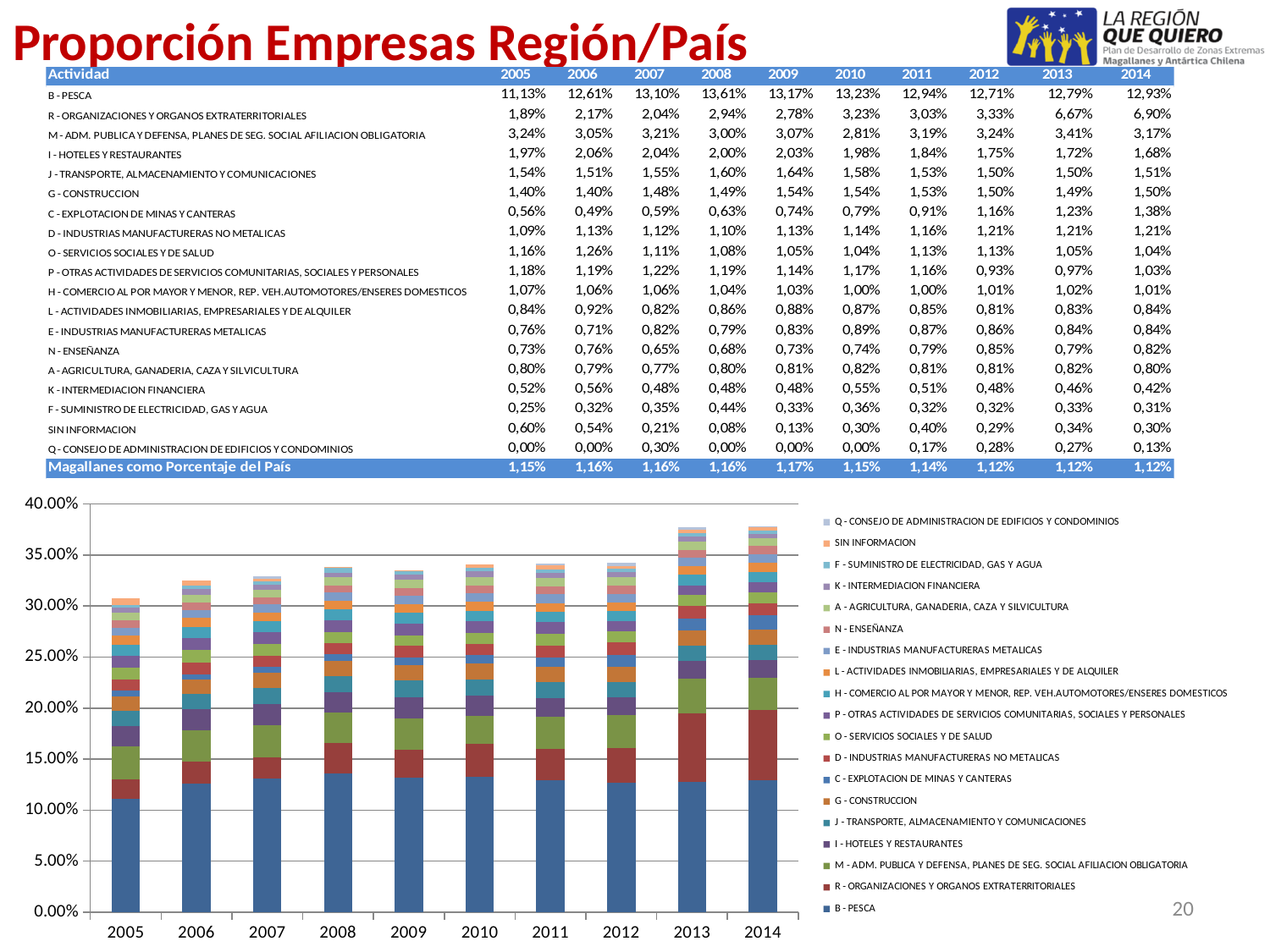
Is the total height of the stacked bar for 2005 greater or less than 35.00%? less How many years are shown along the x axis of the chart? 10 What kind of chart is shown at the bottom of the slide? Stacked bar chart According to the table, which year has the larger value for R - ORGANIZACIONES Y ORGANOS EXTRATERRITORIALES, 2013 or 2014? 2014 According to the table, what is the value for B - PESCA in 2005? 11,13% Which series is shown at the bottom of each stacked bar in the chart? B - PESCA According to the table, in which year is the value for B - PESCA highest? 2008 Do the total heights of the stacked bars generally rise or fall from 2005 to 2014? rise Is the total height of the stacked bar for 2008 greater or less than 30.00%? greater According to the table, what is the difference between the B - PESCA value in 2008 and in 2005? 2,48% How many series does the chart's legend list? 19 Is the total height of the stacked bar for 2013 greater or less than 35.00%? greater